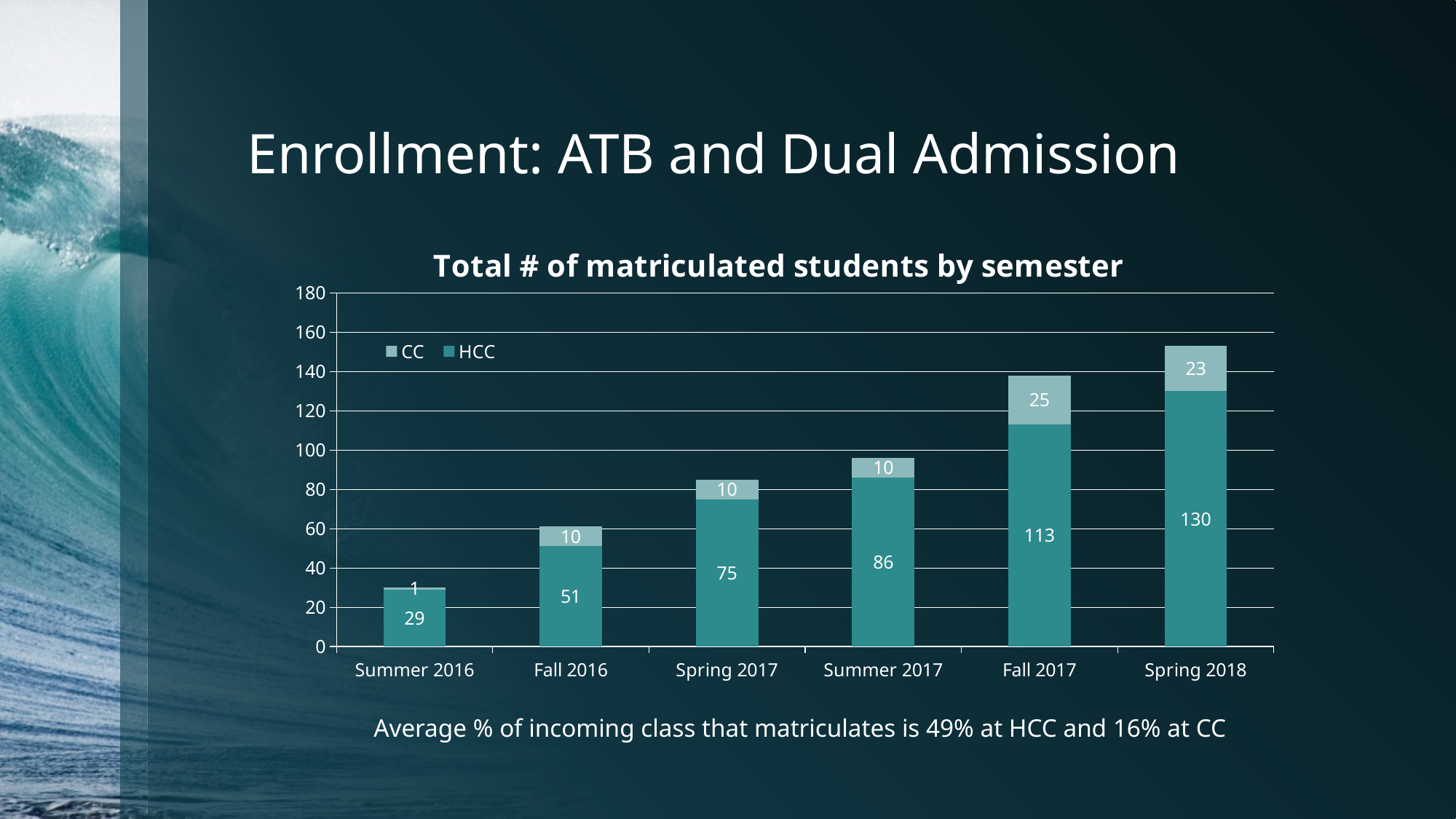
How many series does the legend list? 2 What is the CC value for Spring 2018? 23 What kind of chart is shown? Stacked bar chart Which semester has the lowest CC value? Summer 2016 How many semesters are shown on the x axis? 6 Which semester has the highest HCC value? Spring 2018 What is the total of the stacked bar for Fall 2016? 61 What is the total of the stacked bar for Spring 2018? 153 What is the HCC value for Fall 2017? 113 What is the HCC value for Summer 2016? 29 Which is larger, the CC value for Fall 2017 or the CC value for Spring 2018? Fall 2017 What is the difference between the HCC values for Spring 2018 and Fall 2017? 17